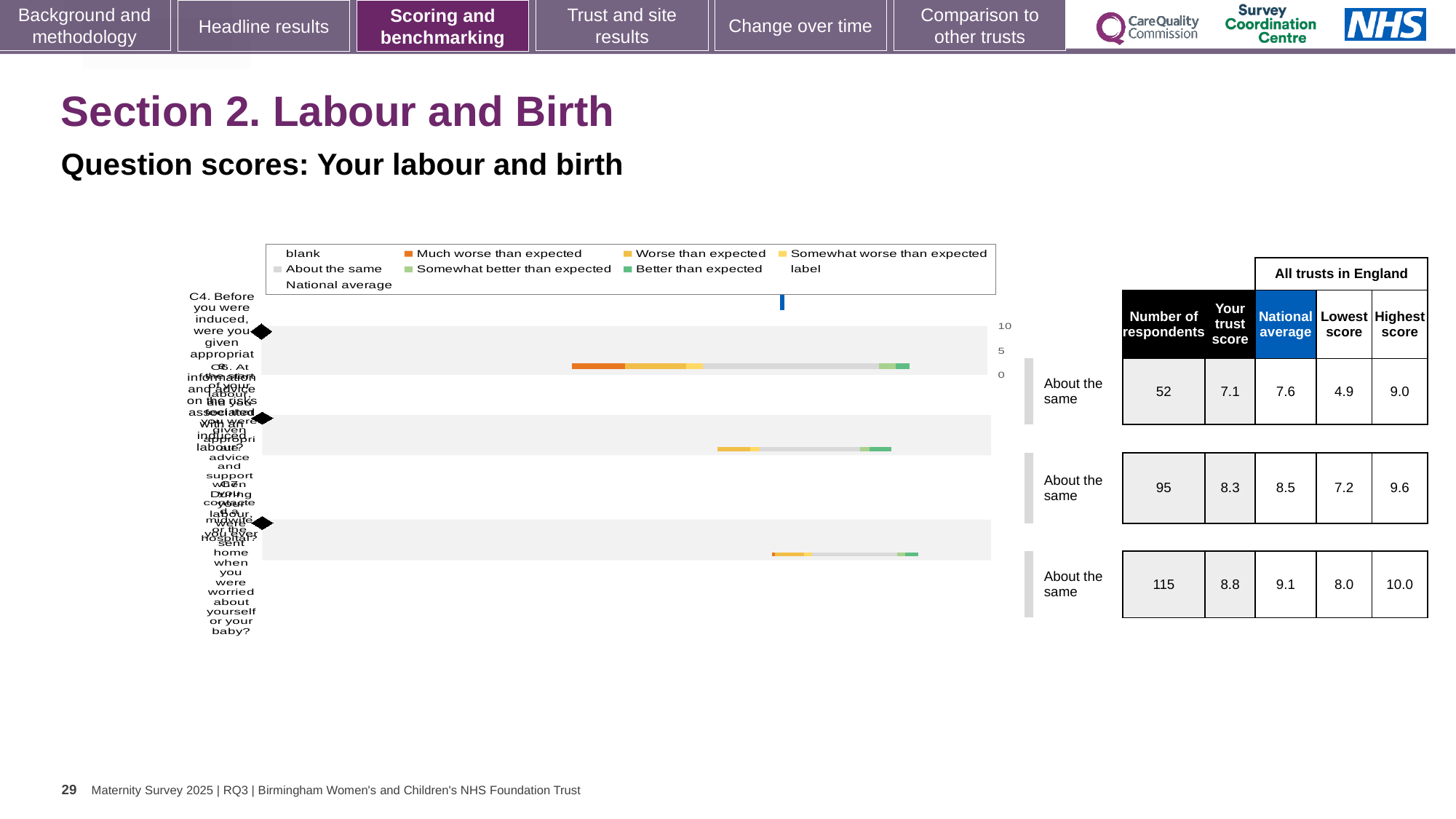
What kind of chart is shown on the slide? bar chart Which question row has the highest number of respondents? the third row (115) For the first question row, what is the difference between the national average (7.6) and the trust score (7.1)? 0.5 In the table beside the chart, what is the national average for the second question row? 8.5 In the table beside the chart, what is the number of respondents for the first question row? 52 What colour is used for the 'Much worse than expected' legend entry? orange How many entries does the chart legend list? 9 How many question rows (bars) are plotted in the chart? 3 In the table beside the chart, what is the trust score for the third question row? 8.8 For the first question row, which is larger: the trust score or the national average? national average What colour is used for the 'Better than expected' legend entry? green In the table beside the chart, what is the highest score in England for the third question row? 10.0